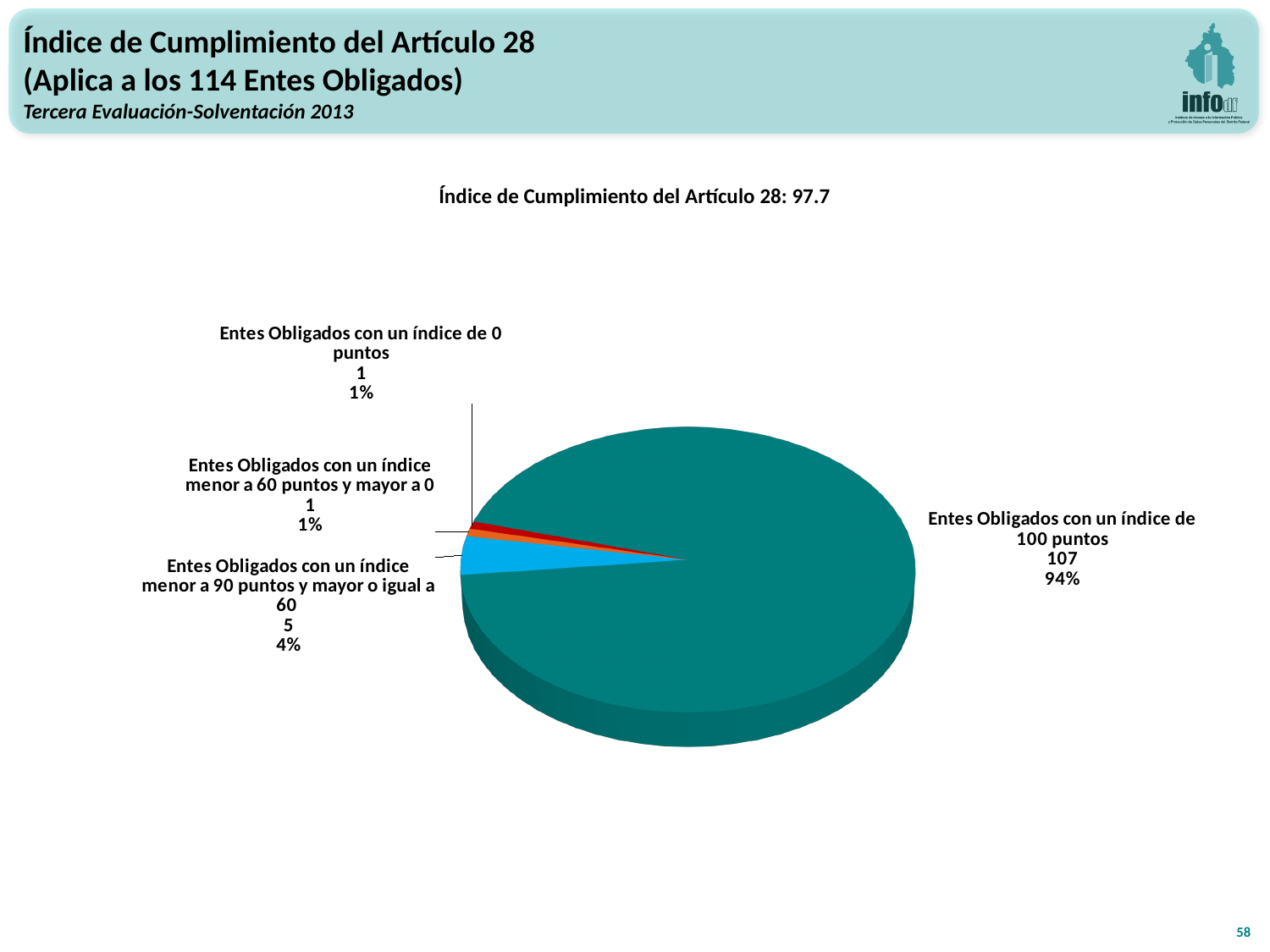
What kind of chart is shown on the slide? Pie chart What is the difference between the number of Entes Obligados with an índice de 100 puntos and those with an índice menor a 90 puntos y mayor o igual a 60? 102 How many Entes Obligados have an índice menor a 90 puntos y mayor o igual a 60? 5 What percentage of the pie is Entes Obligados con un índice menor a 60 puntos y mayor a 0? 1% How many Entes Obligados have an índice de 100 puntos? 107 Which category has the largest slice of the pie? Entes Obligados con un índice de 100 puntos Which is larger: the number of Entes Obligados with an índice menor a 90 puntos y mayor o igual a 60, or the number with an índice de 0 puntos? Entes Obligados con un índice menor a 90 puntos y mayor o igual a 60 How many Entes Obligados have an índice de 0 puntos? 1 How many slices does the pie chart have? 4 What is the value of the Índice de Cumplimiento del Artículo 28 stated above the chart? 97.7 What share of the pie corresponds to Entes Obligados con un índice de 100 puntos? 94% What percentage of the pie is Entes Obligados con un índice menor a 90 puntos y mayor o igual a 60? 4%